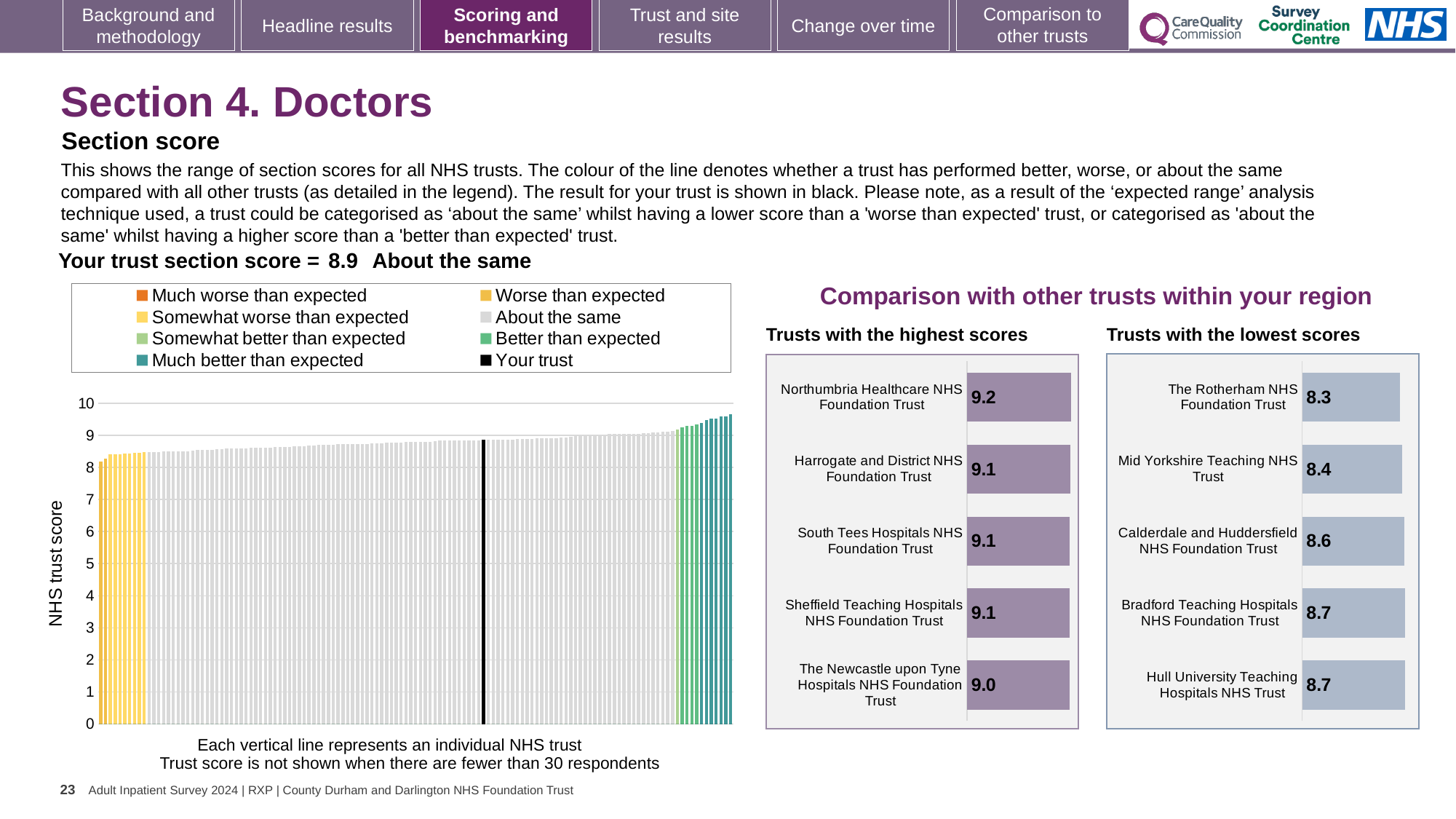
In the 'Trusts with the highest scores' chart, what is the difference between the scores of Northumbria Healthcare NHS Foundation Trust and The Newcastle upon Tyne Hospitals NHS Foundation Trust? 0.2 What is the section score for your trust shown on the slide? 8.9 In the 'Trusts with the lowest scores' chart, which trust has the lowest score? The Rotherham NHS Foundation Trust What type of chart is the large chart on the left showing NHS trust scores? Bar chart How many trusts are listed in the 'Trusts with the highest scores' chart? 5 In the 'Trusts with the lowest scores' chart, which has the larger score: Mid Yorkshire Teaching NHS Trust or Bradford Teaching Hospitals NHS Foundation Trust? Bradford Teaching Hospitals NHS Foundation Trust In the 'Trusts with the lowest scores' chart, what is the score for Calderdale and Huddersfield NHS Foundation Trust? 8.6 In the left-hand NHS trust score chart, do the values rise or fall moving from left to right along the x axis? Rise In the 'Trusts with the lowest scores' chart, what is the difference between the scores of Calderdale and Huddersfield NHS Foundation Trust and The Rotherham NHS Foundation Trust? 0.3 In the 'Trusts with the highest scores' chart, what is the score for Northumbria Healthcare NHS Foundation Trust? 9.2 In the 'Trusts with the highest scores' chart, which trust has the lowest score shown? The Newcastle upon Tyne Hospitals NHS Foundation Trust How many entries does the legend of the left-hand NHS trust score chart list? 8